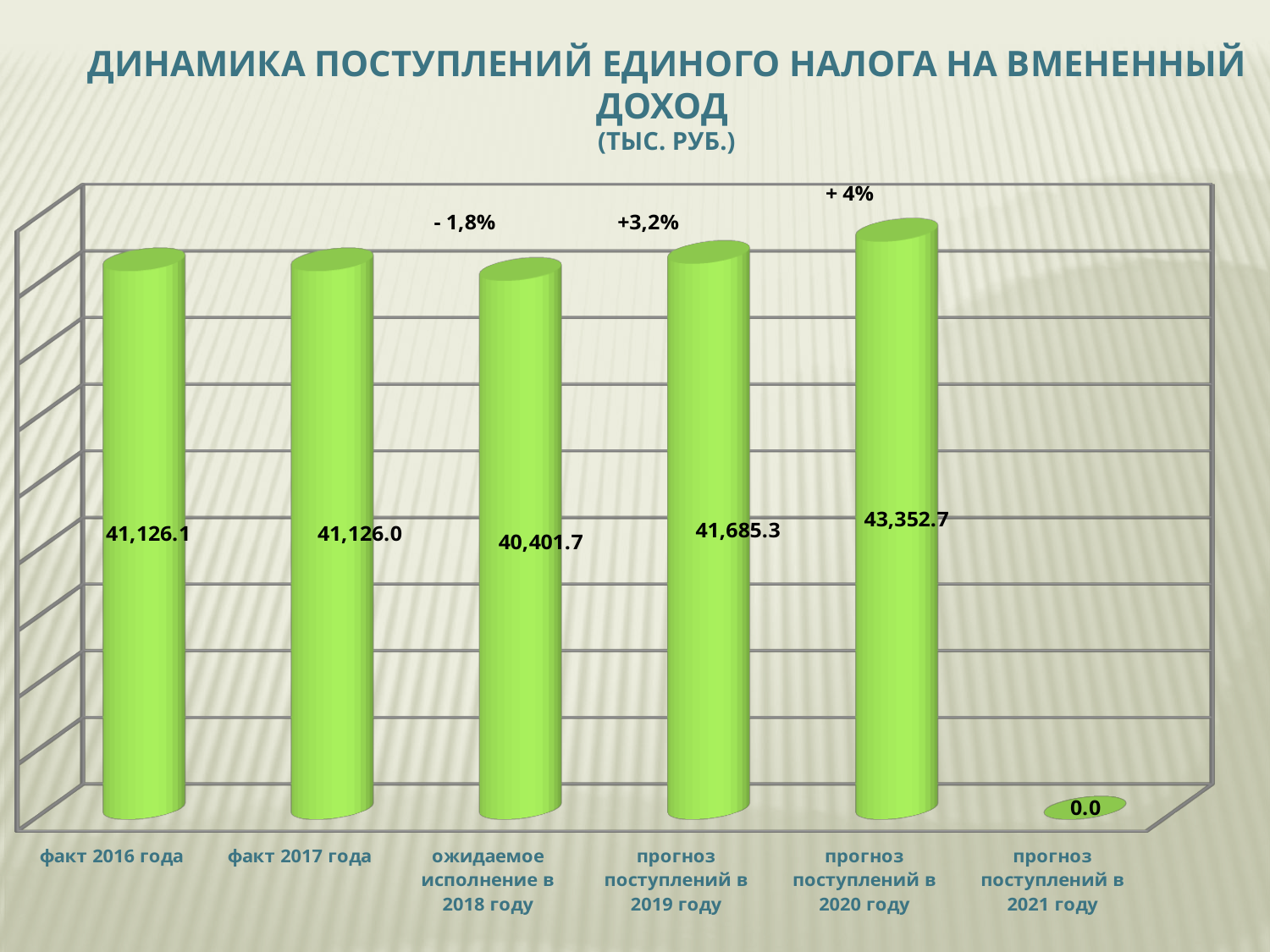
Which category has the highest value? прогноз поступлений в 2020 году Which category has the lowest value? прогноз поступлений в 2021 году What is the difference between the values for факт 2016 года and ожидаемое исполнение в 2018 году? 724.4 What is the value for прогноз поступлений в 2020 году? 43,352.7 What is the value for ожидаемое исполнение в 2018 году? 40,401.7 What is the value for факт 2016 года? 41,126.1 What kind of chart is shown on the slide? bar chart How many categories are shown on the x axis? 6 What percentage change label is printed above the bar for прогноз поступлений в 2020 году? + 4% What is the value for прогноз поступлений в 2021 году? 0.0 What is the difference between the values for прогноз поступлений в 2020 году and прогноз поступлений в 2019 году? 1,667.4 Which is larger: the value for прогноз поступлений в 2019 году or ожидаемое исполнение в 2018 году? прогноз поступлений в 2019 году